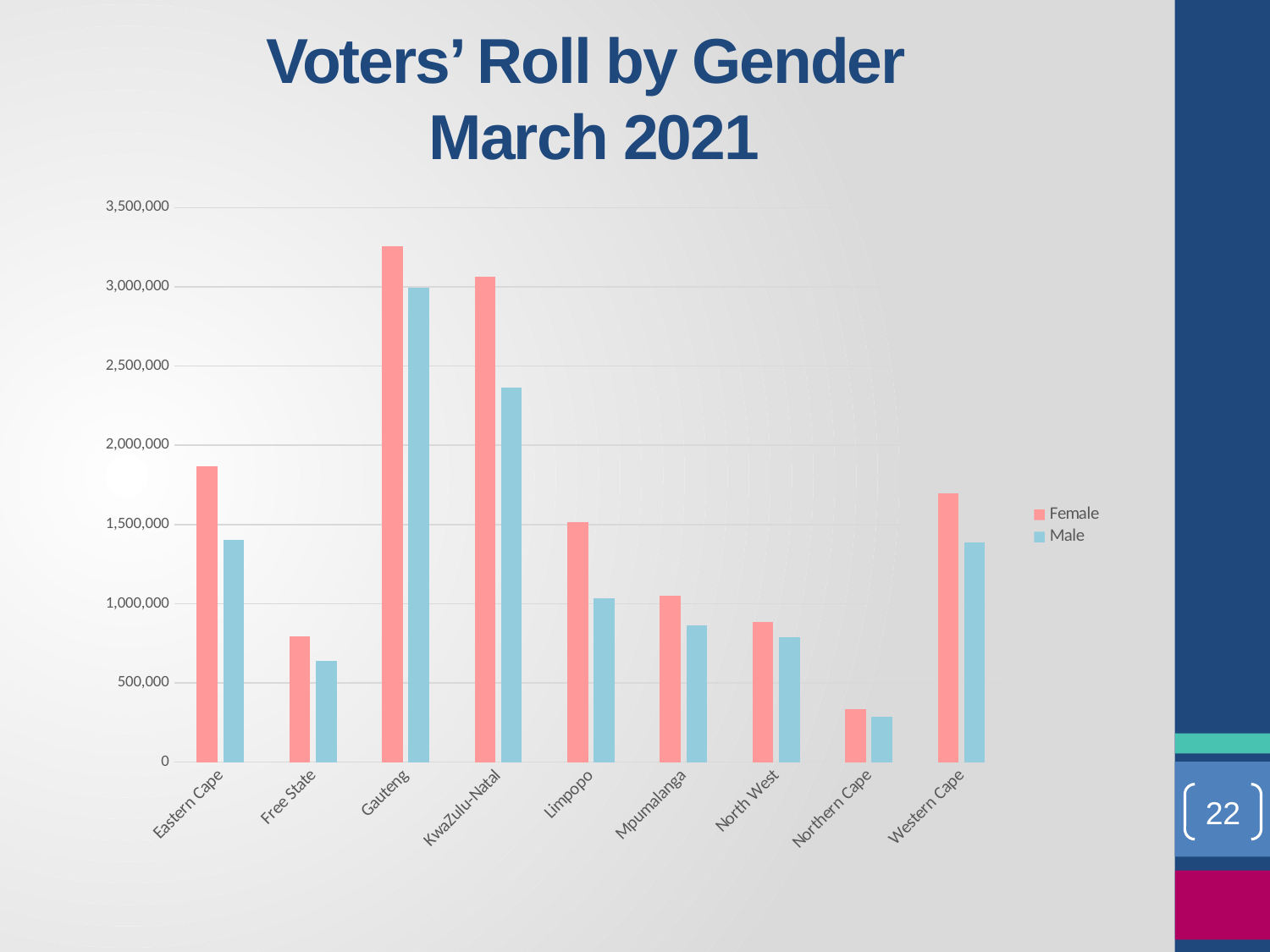
Which province has the highest Female value? Gauteng Which province has the highest Male value? Gauteng Is the Female value for Free State greater or less than 500,000? greater What kind of chart is shown on the slide? Bar chart Is the Male value for KwaZulu-Natal greater or less than 2,500,000? less Which is larger in KwaZulu-Natal, the Female value or the Male value? Female Which province has the lowest Female value? Northern Cape How many series does the legend list? 2 How many provinces (categories) are shown on the x axis? 9 Is the Female value for Gauteng greater or less than 3,000,000? greater What is the title of the chart on the slide? Voters' Roll by Gender March 2021